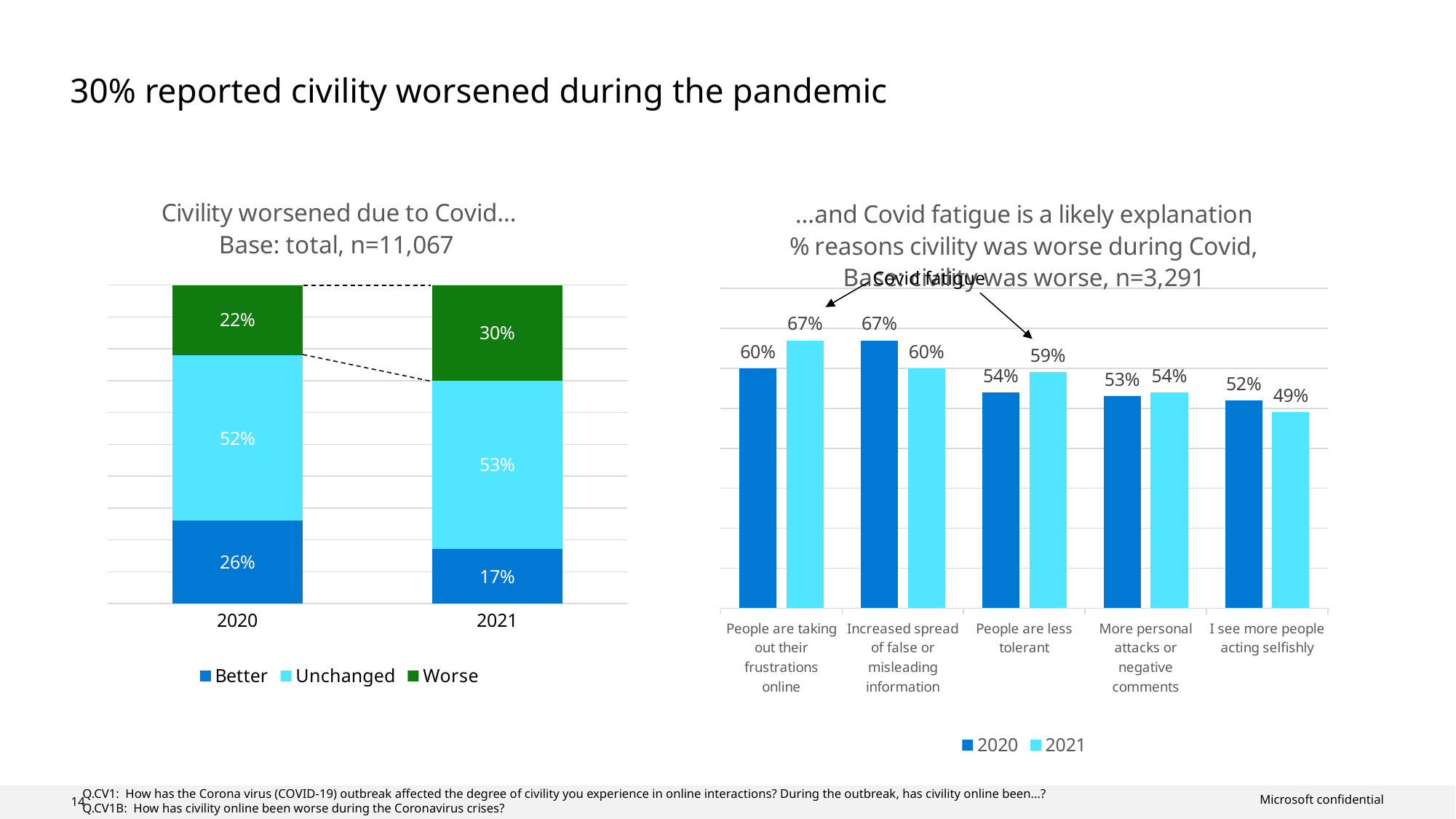
What kind of chart is the left chart 'Civility worsened due to Covid...'? Stacked bar chart In the right chart '...and Covid fatigue is a likely explanation', what is the 2021 value for 'People are taking out their frustrations online'? 67% In the left chart 'Civility worsened due to Covid...', by how many percentage points did the Worse share increase from 2020 to 2021? 8 percentage points In the right chart '...and Covid fatigue is a likely explanation', which reason has the lowest 2021 value? I see more people acting selfishly In the left chart 'Civility worsened due to Covid...', what is the total of the stacked bar for 2020? 100% In the left chart 'Civility worsened due to Covid...', how many series does the legend list? 3 In the right chart '...and Covid fatigue is a likely explanation', what is the 2020 value for 'I see more people acting selfishly'? 52% In the right chart '...and Covid fatigue is a likely explanation', how many reason categories are shown on the x axis? 5 In the left chart 'Civility worsened due to Covid...', what percentage reported civility was Worse in 2021? 30% In the left chart 'Civility worsened due to Covid...', what percentage reported civility was Better in 2020? 26% In the right chart '...and Covid fatigue is a likely explanation', is the 2020 value for 'People are less tolerant' larger or smaller than the 2021 value? smaller In the right chart '...and Covid fatigue is a likely explanation', what is the difference between the 2020 and 2021 values for 'Increased spread of false or misleading information'? 7 percentage points